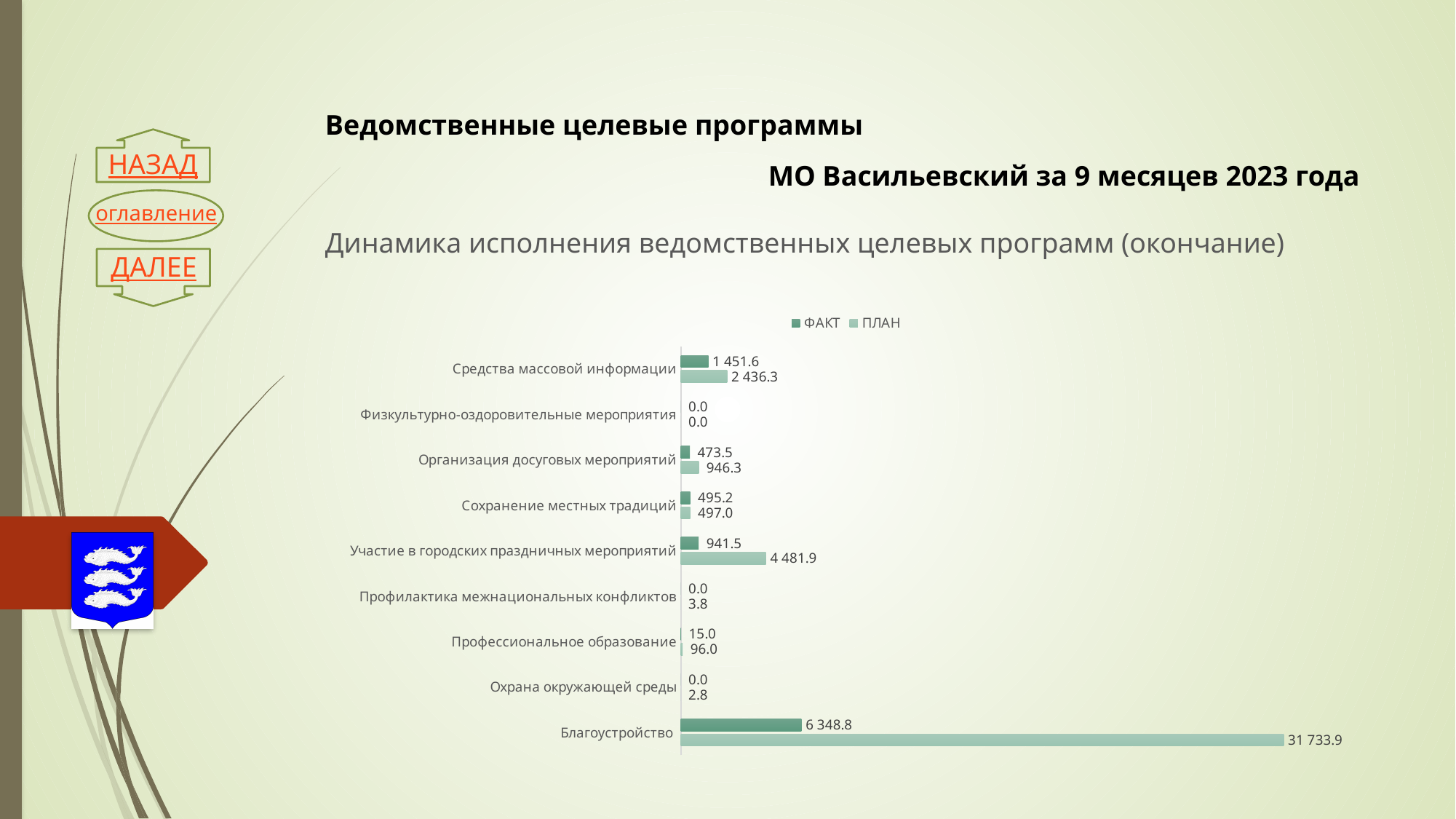
Which is larger: the ФАКТ value for Средства массовой информации or the ФАКТ value for Участие в городских праздничных мероприятий? Средства массовой информации Which category has the lowest non-zero ПЛАН value? Охрана окружающей среды What is the ПЛАН value for Профессиональное образование? 96.0 What is the ПЛАН value for Участие в городских праздничных мероприятий? 4 481.9 Which category has the highest ПЛАН value? Благоустройство What is the difference between the ПЛАН and ФАКТ values for Организация досуговых мероприятий? 472.8 How many series does the legend list? 2 How many categories are shown on the chart? 9 What is the difference between the ПЛАН and ФАКТ values for Благоустройство? 25 385.1 What is the ФАКТ value for Сохранение местных традиций? 495.2 What type of chart is shown on the slide? Bar chart What is the ФАКТ value for Средства массовой информации? 1 451.6